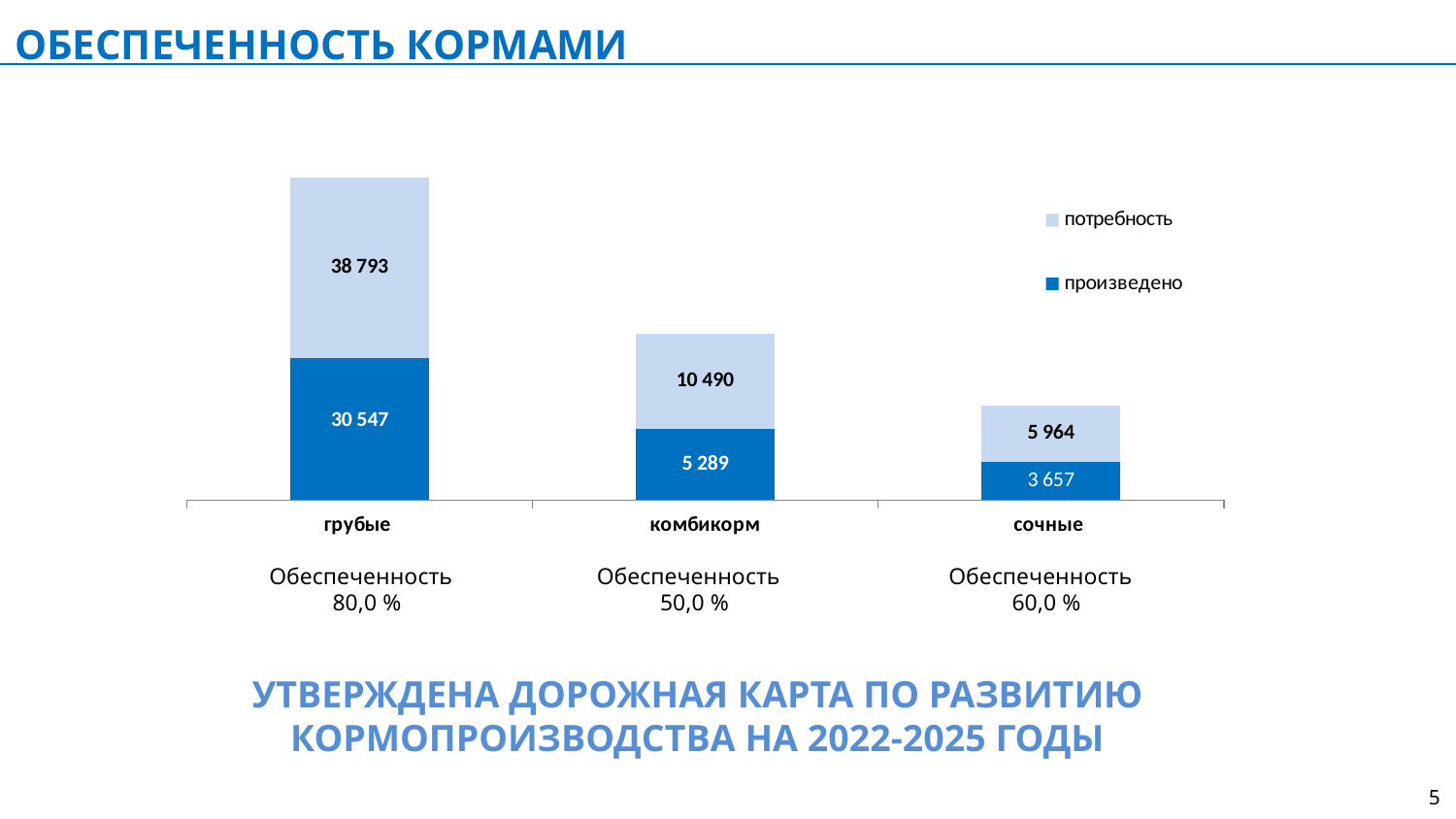
What is the difference between потребность and произведено for грубые? 8 246 How many series does the legend list? 2 Which category has the highest произведено value? грубые What is the потребность value for грубые? 38 793 What is the произведено value for комбикорм? 5 289 How many categories are shown on the x axis? 3 What is the difference between потребность and произведено for комбикорм? 5 201 What kind of chart is shown on the slide? stacked bar chart What is the потребность value for сочные? 5 964 What is the произведено value for сочные? 3 657 Which category has the lowest потребность value? сочные Which is larger: the произведено value for комбикорм or the произведено value for сочные? комбикорм